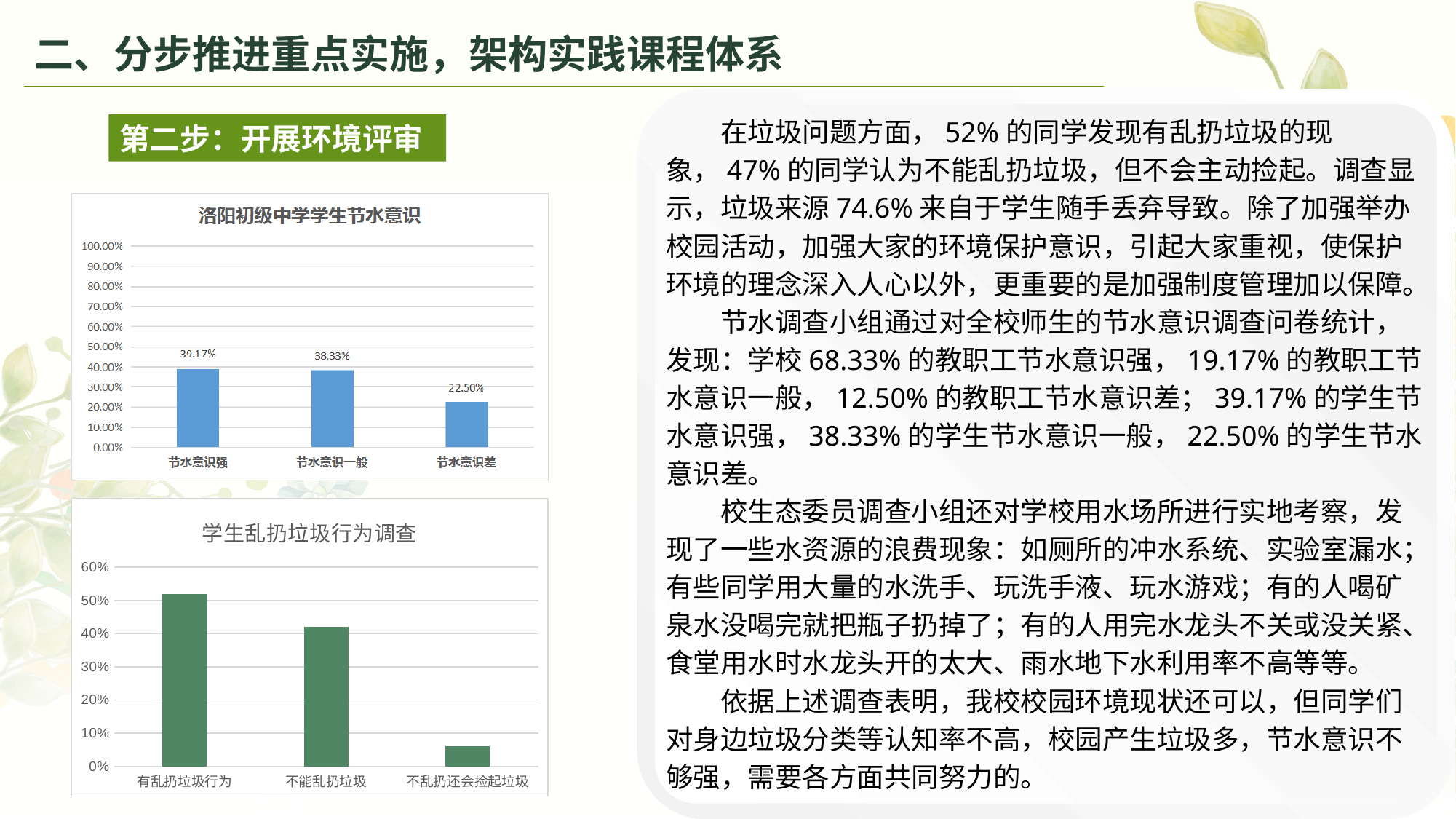
In the chart titled 洛阳初级中学学生节水意识, what is the value for 节水意识差? 22.50% In the chart titled 学生乱扔垃圾行为调查, is the value for 不乱扔还会捡起垃圾 greater or less than 10%? less In the chart titled 洛阳初级中学学生节水意识, what is the value for 节水意识强? 39.17% In the chart titled 洛阳初级中学学生节水意识, what is the difference between the values for 节水意识强 and 节水意识差? 16.67% In the chart titled 洛阳初级中学学生节水意识, which category has the lowest value? 节水意识差 In the chart titled 洛阳初级中学学生节水意识, what is the value for 节水意识一般? 38.33% What kind of chart is the chart titled 学生乱扔垃圾行为调查? bar chart In the chart titled 学生乱扔垃圾行为调查, which category has the lowest value? 不乱扔还会捡起垃圾 In the chart titled 学生乱扔垃圾行为调查, which category has the highest value? 有乱扔垃圾行为 In the chart titled 学生乱扔垃圾行为调查, which is larger: the value for 不能乱扔垃圾 or the value for 不乱扔还会捡起垃圾? 不能乱扔垃圾 In the chart titled 洛阳初级中学学生节水意识, how many categories are shown on the x axis? 3 In the chart titled 学生乱扔垃圾行为调查, is the value for 有乱扔垃圾行为 greater or less than 50%? greater